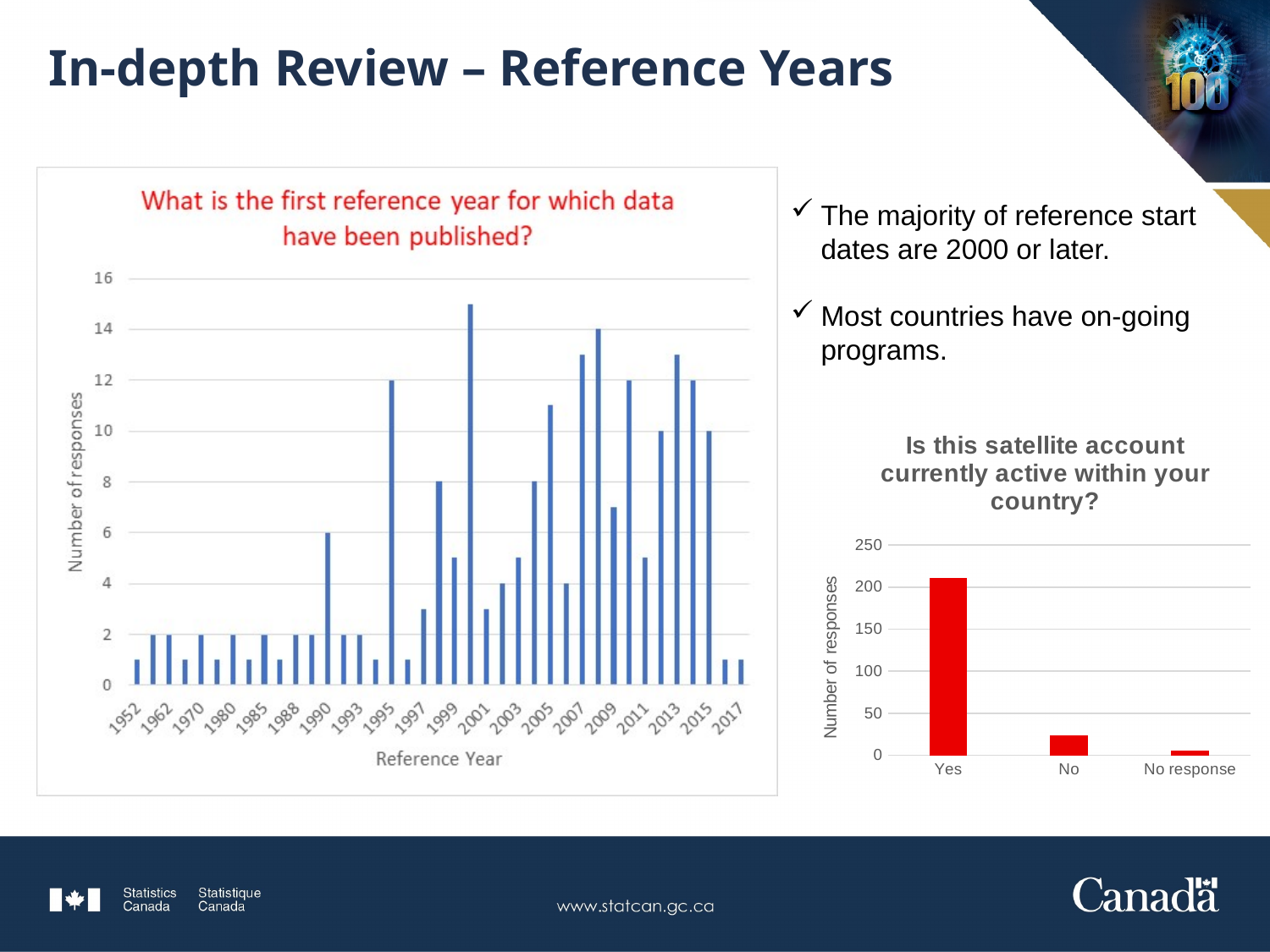
On the chart titled 'What is the first reference year for which data have been published?', is the value for 1952 greater or less than 2? less On the chart titled 'Is this satellite account currently active within your country?', which category has the lowest number of responses? No response What colour are the bars on the chart titled 'Is this satellite account currently active within your country?' red On the chart titled 'What is the first reference year for which data have been published?', is the value for 1995 greater or less than 10? greater On the chart titled 'What is the first reference year for which data have been published?', what is the label of the x axis? Reference Year What kind of chart is the one titled 'Is this satellite account currently active within your country?' bar chart On the chart titled 'Is this satellite account currently active within your country?', which is larger, the value for Yes or the value for No? Yes What kind of chart is the one titled 'What is the first reference year for which data have been published?' bar chart On the chart titled 'Is this satellite account currently active within your country?', is the value for No greater or less than 50? less How many categories are shown on the chart titled 'Is this satellite account currently active within your country?' 3 On the chart titled 'Is this satellite account currently active within your country?', which category has the highest number of responses? Yes